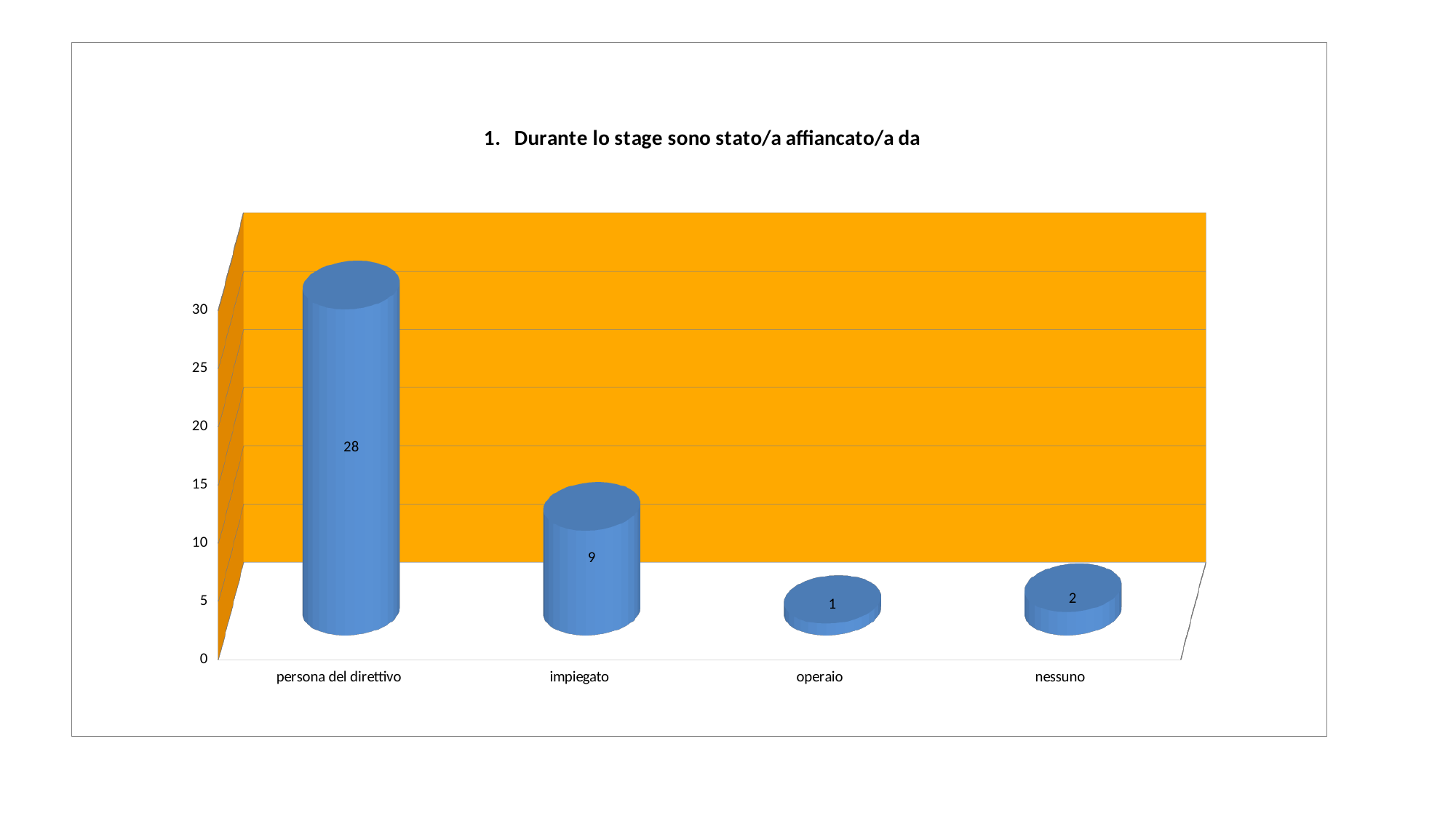
What is the value for 'nessuno'? 2 How many categories are shown on the x axis? 4 What kind of chart is shown on the slide? bar chart What is the value for 'persona del direttivo'? 28 What is the difference between the values for 'persona del direttivo' and 'impiegato'? 19 What is the title of the chart? 1. Durante lo stage sono stato/a affiancato/a da Which category has the lowest value? operaio What is the value for 'impiegato'? 9 Which category has the highest value? persona del direttivo Is the value for 'impiegato' greater or less than 10? less What is the value for 'operaio'? 1 Which is larger, the value for 'nessuno' or the value for 'operaio'? nessuno